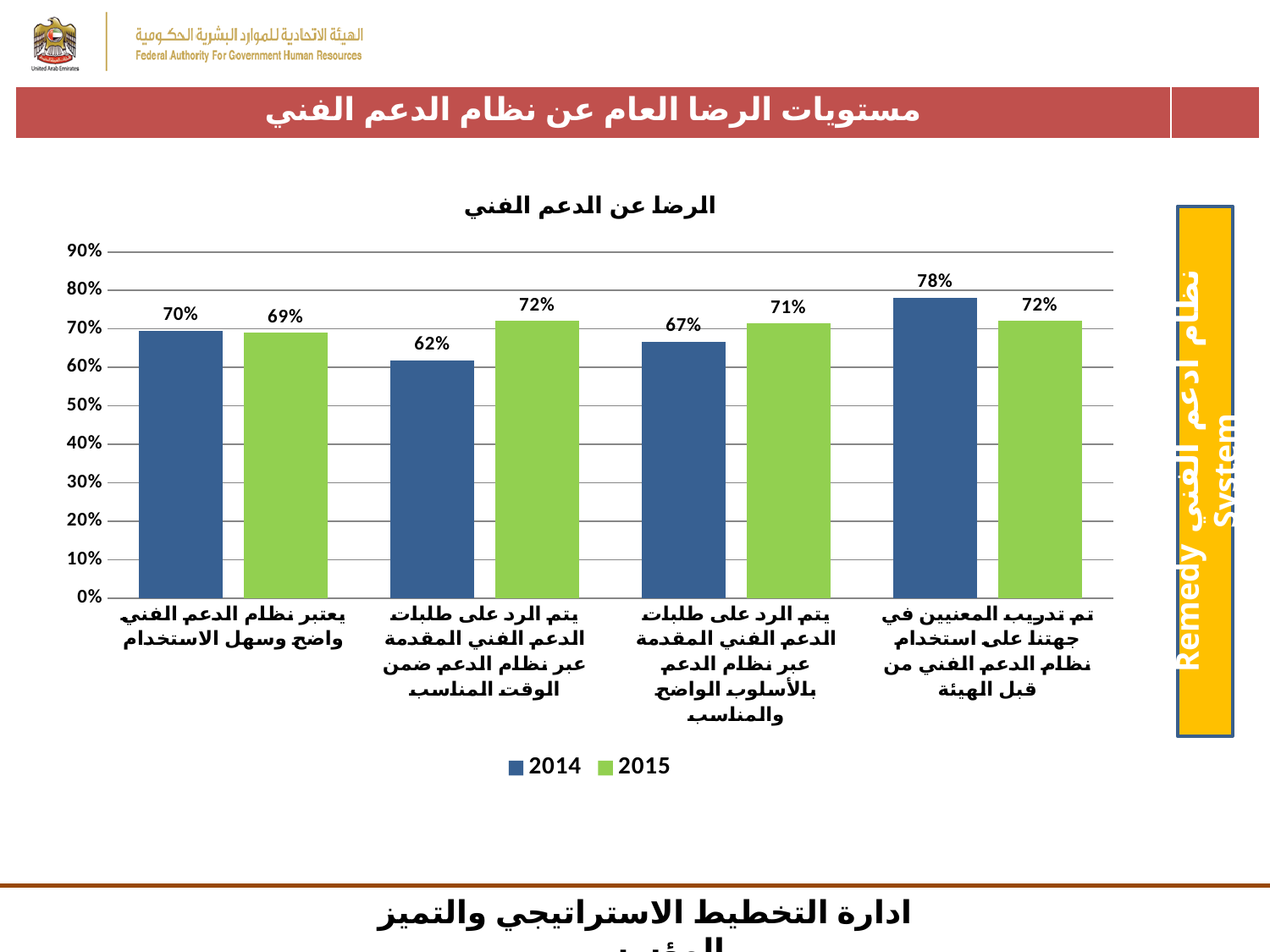
How many series does the legend list in the chart? 2 What is the 2015 value for "يتم الرد على طلبات الدعم الفني المقدمة عبر نظام الدعم ضمن الوقت المناسب"? 72% Which category has the highest 2014 value? تم تدريب المعنيين في جهتنا على استخدام نظام الدعم الفني من قبل الهيئة Which category has the lowest 2015 value? يعتبر نظام الدعم الفني واضح وسهل الاستخدام What is the 2014 value for "يعتبر نظام الدعم الفني واضح وسهل الاستخدام"? 70% What is the difference between the 2015 and 2014 values for "يتم الرد على طلبات الدعم الفني المقدمة عبر نظام الدعم ضمن الوقت المناسب"? 10% What is the 2014 value for "تم تدريب المعنيين في جهتنا على استخدام نظام الدعم الفني من قبل الهيئة"? 78% What type of chart is shown on the slide? bar chart What is the title of the chart? الرضا عن الدعم الفني For "تم تدريب المعنيين في جهتنا على استخدام نظام الدعم الفني من قبل الهيئة", which year has the larger value, 2014 or 2015? 2014 How many categories are shown on the x axis of the chart? 4 Which category has the lowest 2014 value? يتم الرد على طلبات الدعم الفني المقدمة عبر نظام الدعم ضمن الوقت المناسب